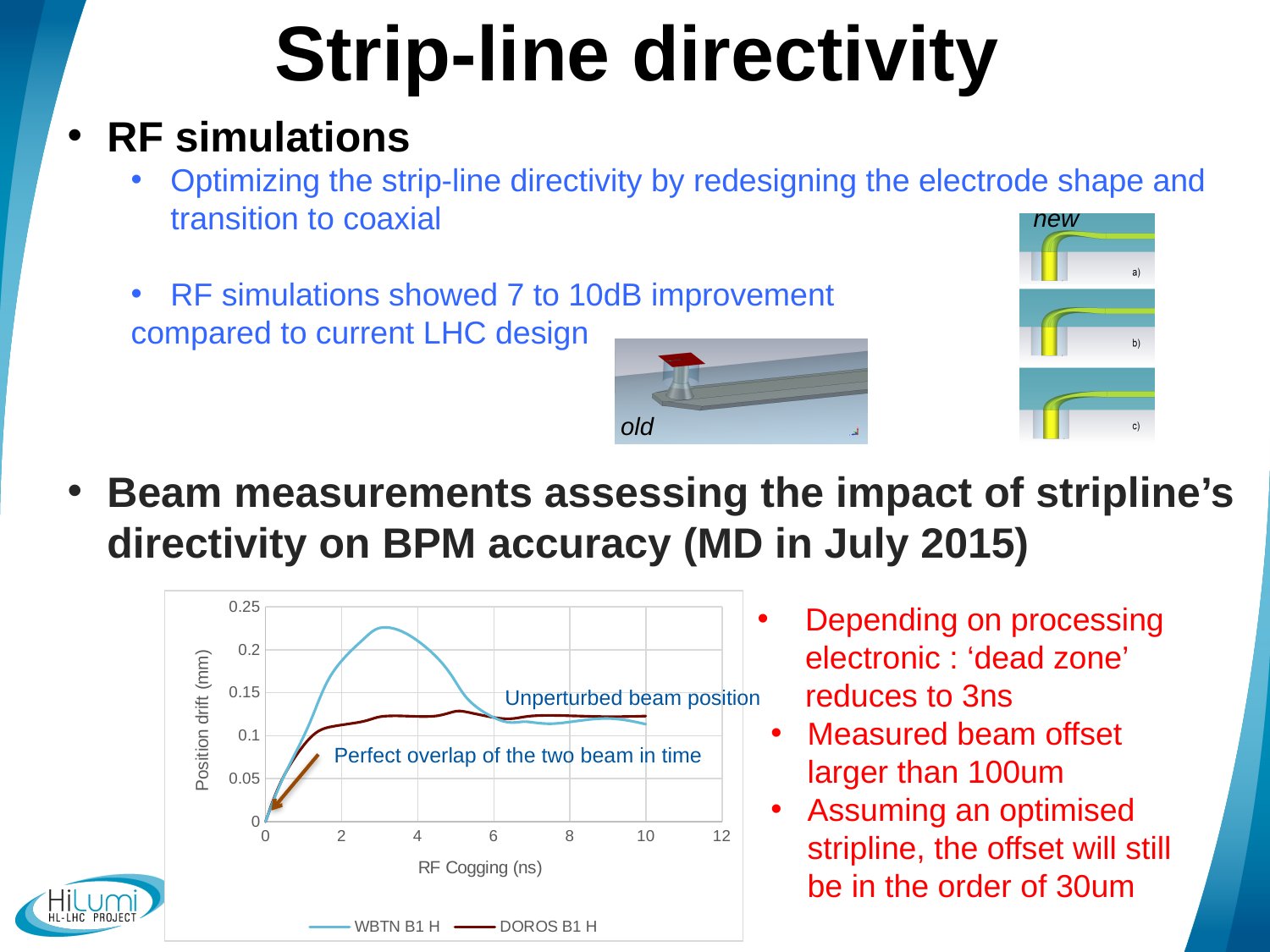
Does the WBTN B1 H line rise or fall between 0 and 3 ns on the x axis? rise Which series reaches the higher maximum position drift, WBTN B1 H or DOROS B1 H? WBTN B1 H Is the value of the DOROS B1 H line at 8 ns greater or less than 0.1? greater What is the label of the x axis of the chart? RF Cogging (ns) Is the peak value of the WBTN B1 H line greater or less than 0.2? greater Is the highest value of the DOROS B1 H line greater or less than 0.15? less What are the two series named in the chart legend? WBTN B1 H and DOROS B1 H Does the WBTN B1 H line rise or fall between 3 and 6 ns on the x axis? fall What is the maximum value shown on the y axis of the chart? 0.25 What kind of chart is shown at the bottom left of the slide? Line chart At an RF cogging of 3 ns, which series has the larger position drift, WBTN B1 H or DOROS B1 H? WBTN B1 H How many series does the legend of the chart list? 2